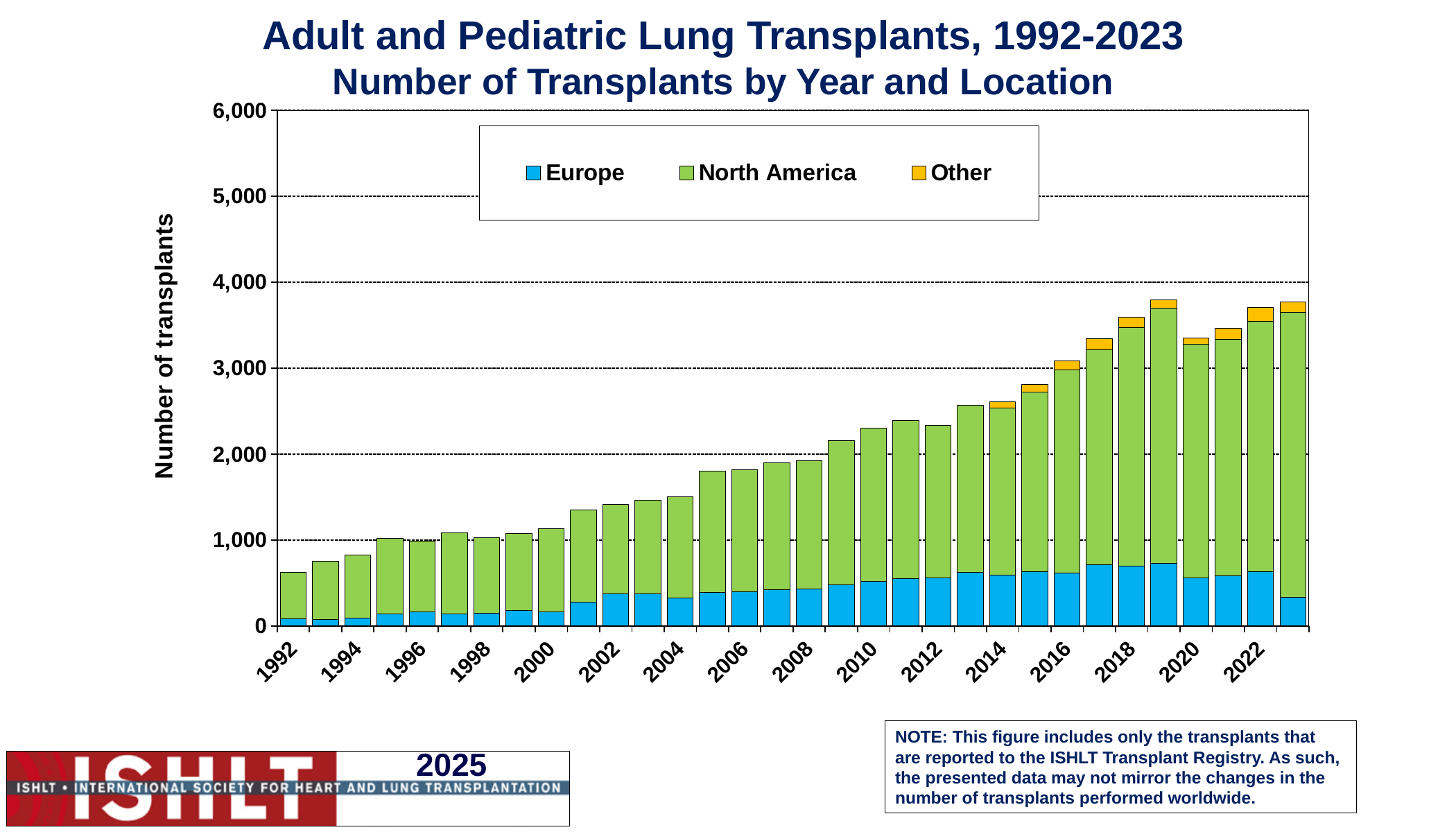
Is the total number of transplants in 2019 greater or less than 4,000? less Is the total number of transplants in 2016 greater or less than 3,000? greater Is the total number of transplants in 1992 greater or less than 1,000? less How many years (bars) are plotted in the chart? 32 What kind of chart is shown on the slide? Stacked bar chart Which year has the lowest total number of transplants? 1992 What is the label of the y axis? Number of transplants Overall, do the total number of transplants rise or fall from 1992 to 2023? rise Which year has a larger total number of transplants, 2019 or 2020? 2019 Which year has the highest total number of transplants? 2019 How many series does the legend list? 3